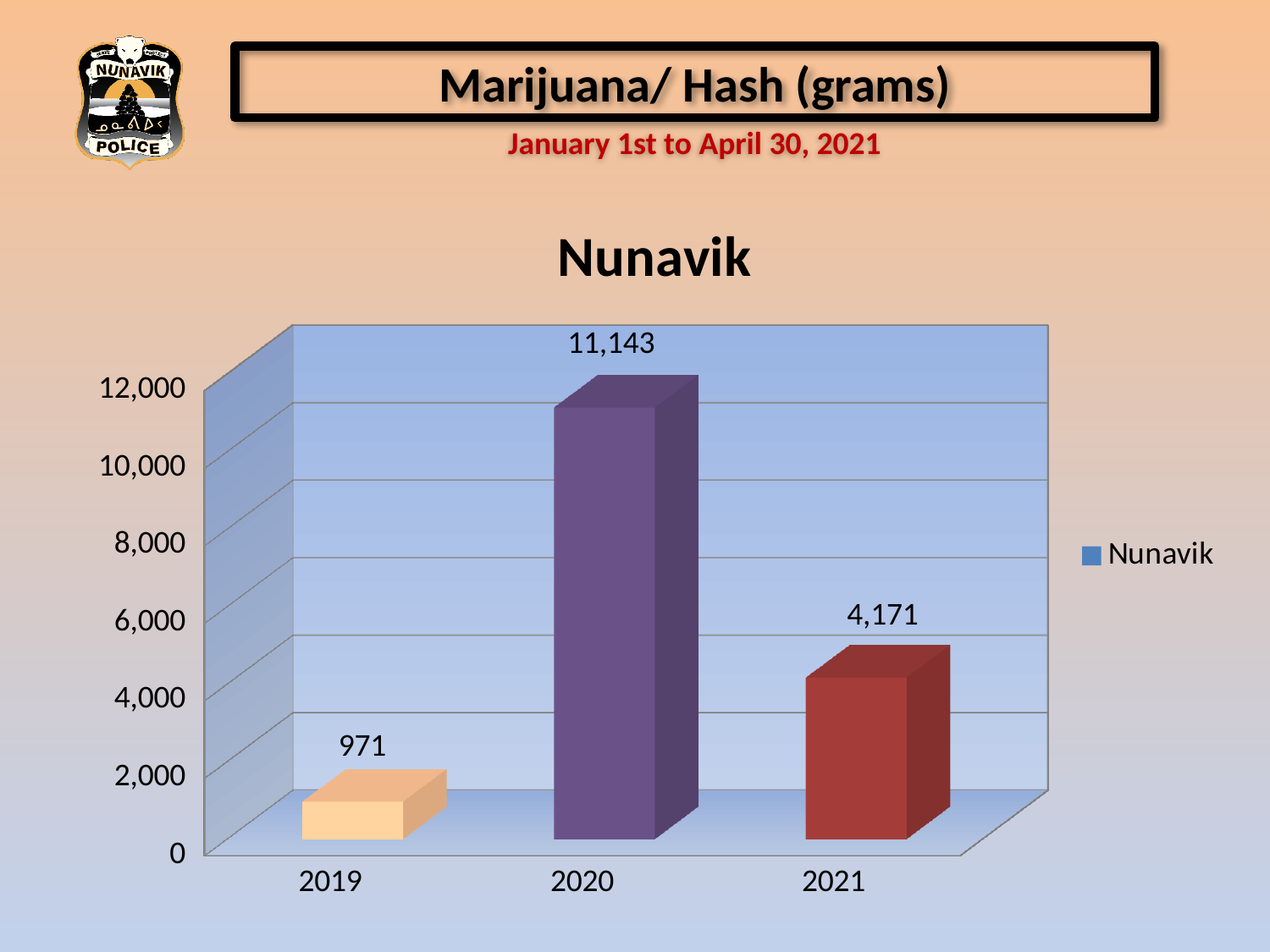
What kind of chart is shown? bar chart How many years are shown on the x axis? 3 Which year has the highest value? 2020 What is the difference between the values for 2020 and 2021? 6,972 What is the value for 2021? 4,171 What is the value for 2020? 11,143 What is the difference between the values for 2021 and 2019? 3,200 Is the value for 2021 greater or less than 6,000? less Which is larger, the value for 2019 or the value for 2021? 2021 What is the title of the chart? Nunavik Which year has the lowest value? 2019 What is the value for 2019? 971